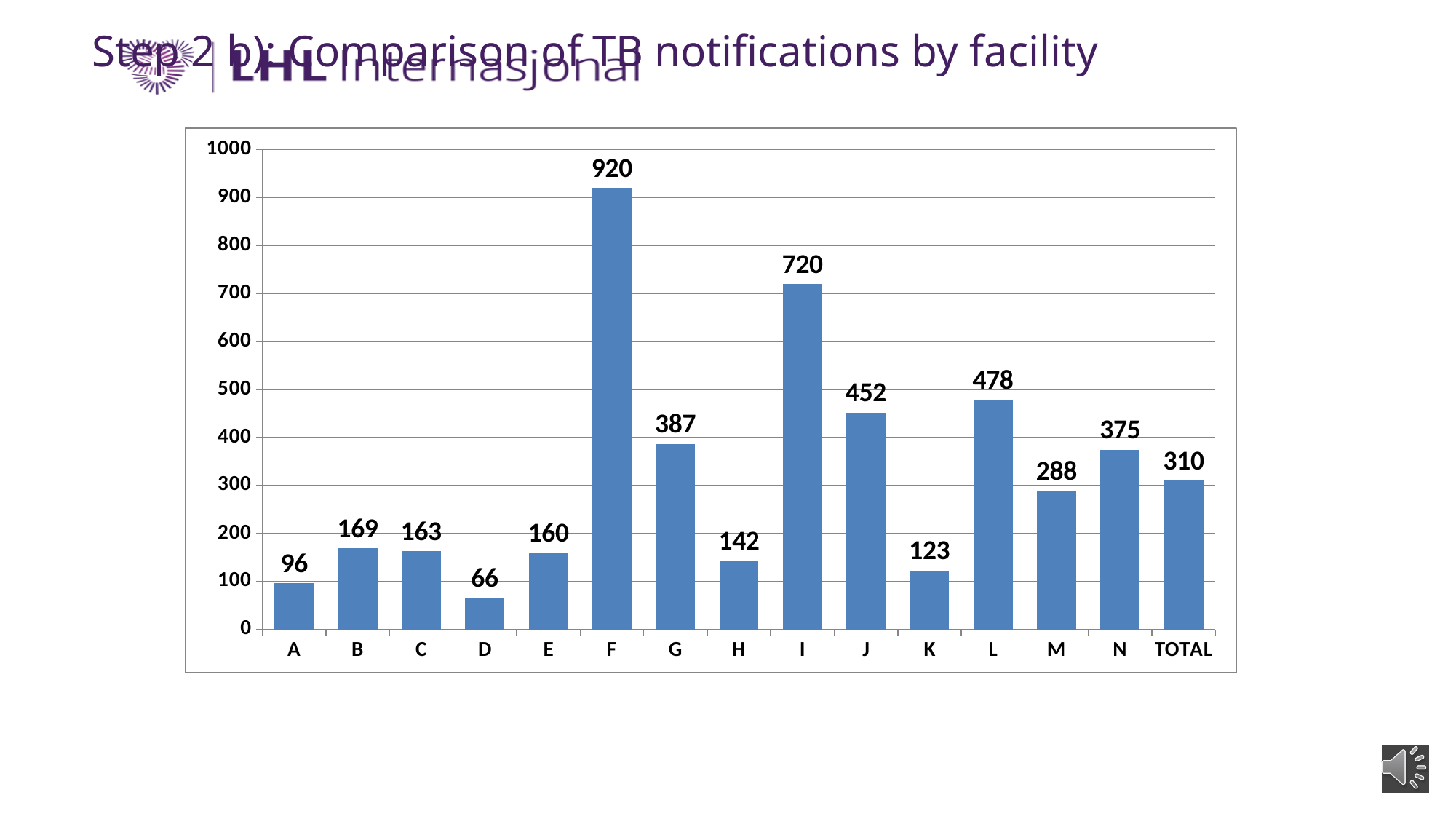
What is the difference between the values for facility L and facility J? 26 Is the value for facility M greater or less than 300? less How many bars are shown in the chart? 15 What is the value for facility K? 123 Which is larger, the value for facility G or the value for facility N? G What is the difference between the values for facility F and facility I? 200 What is the maximum value shown on the vertical axis? 1000 Which facility has the highest number of TB notifications? F What is the value for facility F? 920 What kind of chart is shown on the slide? bar chart Which facility has the lowest number of TB notifications? D What is the value shown for the TOTAL bar? 310